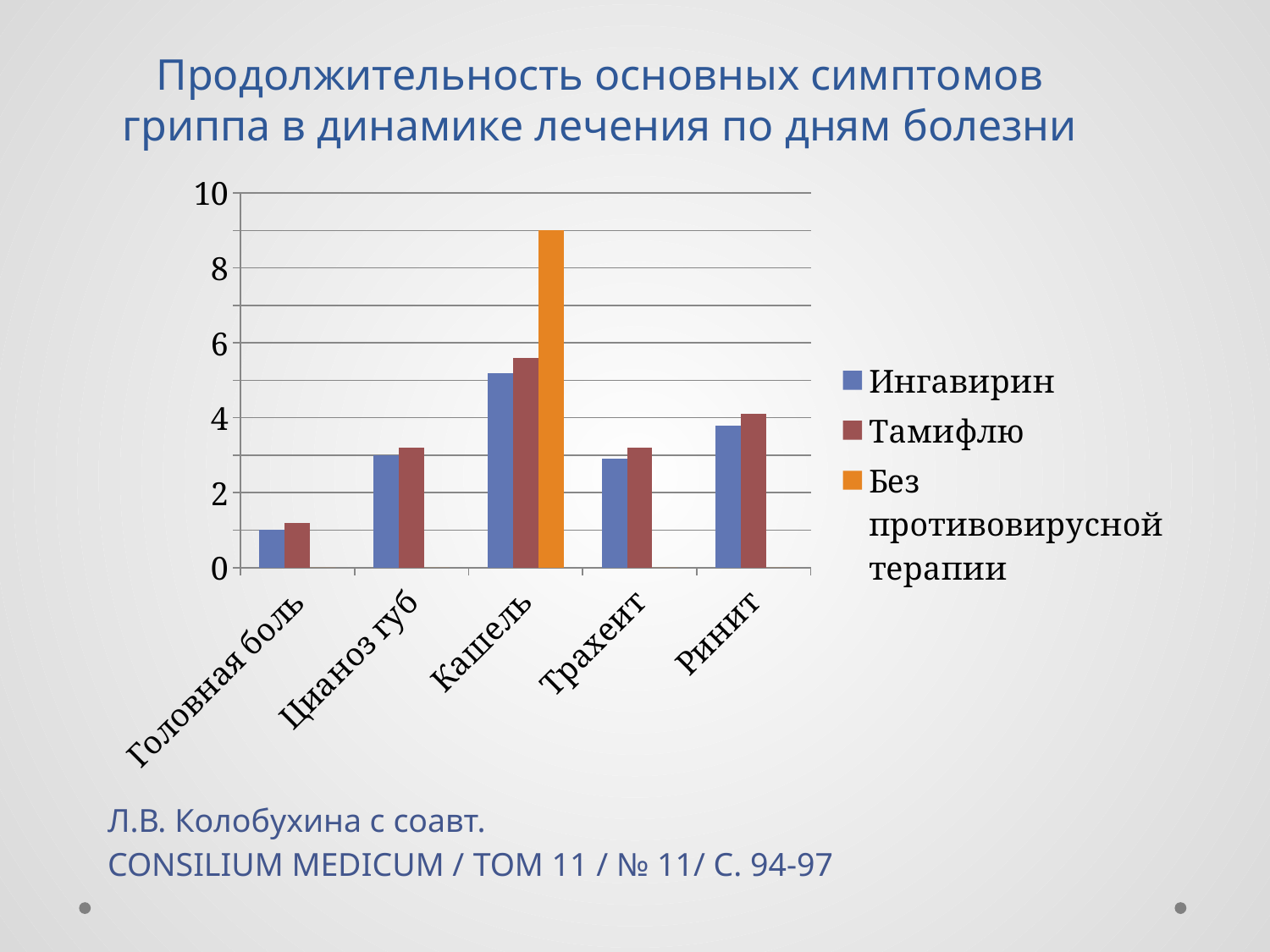
Is the value for Без противовирусной терапии for Кашель greater or less than 8? greater Which category has the highest bar in the chart? Кашель Is the value for Тамифлю for Головная боль greater or less than 2? less For which category only does the legend series Без противовирусной терапии have a bar? Кашель Which category has the lowest value for Ингавирин? Головная боль For Кашель, which is larger: the value for Ингавирин or the value for Без противовирусной терапии? Без противовирусной терапии How many symptom categories are shown on the x axis? 5 What colour represents Тамифлю in the legend? red (dark red) What kind of chart is shown on the slide? bar chart How many series does the legend list? 3